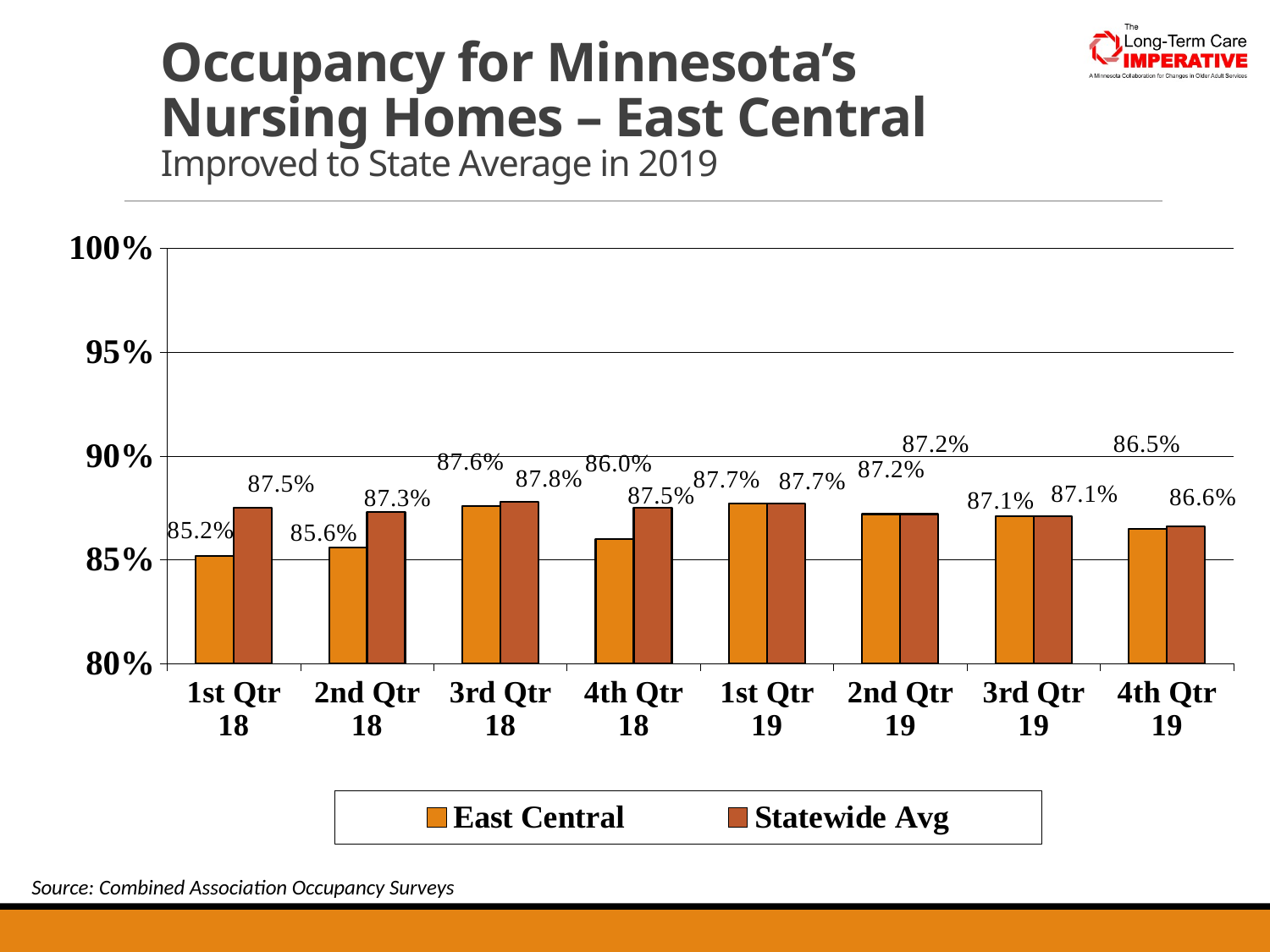
In which quarter was East Central occupancy lowest? 1st Qtr 18 What was the East Central occupancy in 1st Qtr 18? 85.2% Which was higher in 4th Qtr 18, East Central or Statewide Avg? Statewide Avg What type of chart is shown on the slide? Bar chart How many series does the legend list? 2 Did East Central occupancy rise or fall from 1st Qtr 18 to 1st Qtr 19? Rise What is the difference between the Statewide Avg and East Central occupancy in 2nd Qtr 18? 1.7% In which quarter was the Statewide Avg occupancy highest? 3rd Qtr 18 What was the East Central occupancy in 4th Qtr 19? 86.5% What was the Statewide Avg occupancy in 4th Qtr 18? 87.5% How many quarters are shown on the x axis? 8 What is the difference between the Statewide Avg and East Central occupancy in 1st Qtr 18? 2.3%